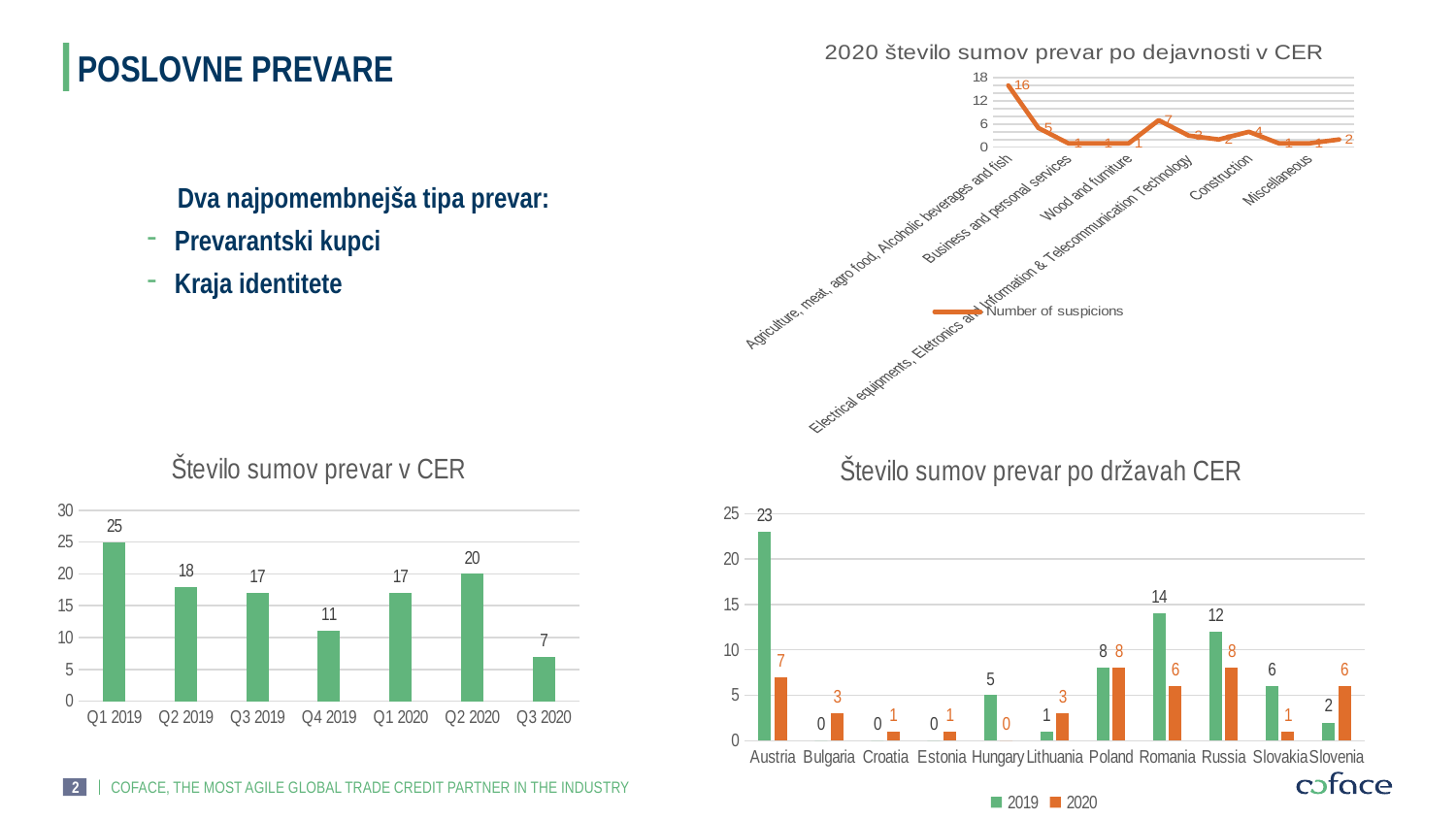
How many countries are shown in the chart 'Število sumov prevar po državah CER'? 11 In the chart 'Število sumov prevar v CER', which quarter has the lowest value? Q3 2020 In the chart '2020 število sumov prevar po dejavnosti v CER', what is the value for Business and personal services? 1 In the chart 'Število sumov prevar po državah CER', which is larger for Russia: the 2019 value or the 2020 value? 2019 In the chart 'Število sumov prevar po državah CER', what is the 2019 value for Romania? 14 In the chart 'Število sumov prevar po državah CER', what is the 2020 value for Slovenia? 6 In the chart 'Število sumov prevar po državah CER', which country has the highest 2019 value? Austria In the chart 'Število sumov prevar v CER', what is the difference between Q2 2020 and Q4 2019? 9 What kind of chart is '2020 število sumov prevar po dejavnosti v CER'? line chart In the chart 'Število sumov prevar v CER', what is the value for Q1 2019? 25 How many quarters are shown in the chart 'Število sumov prevar v CER'? 7 How many series does the legend list in the chart 'Število sumov prevar po državah CER'? 2